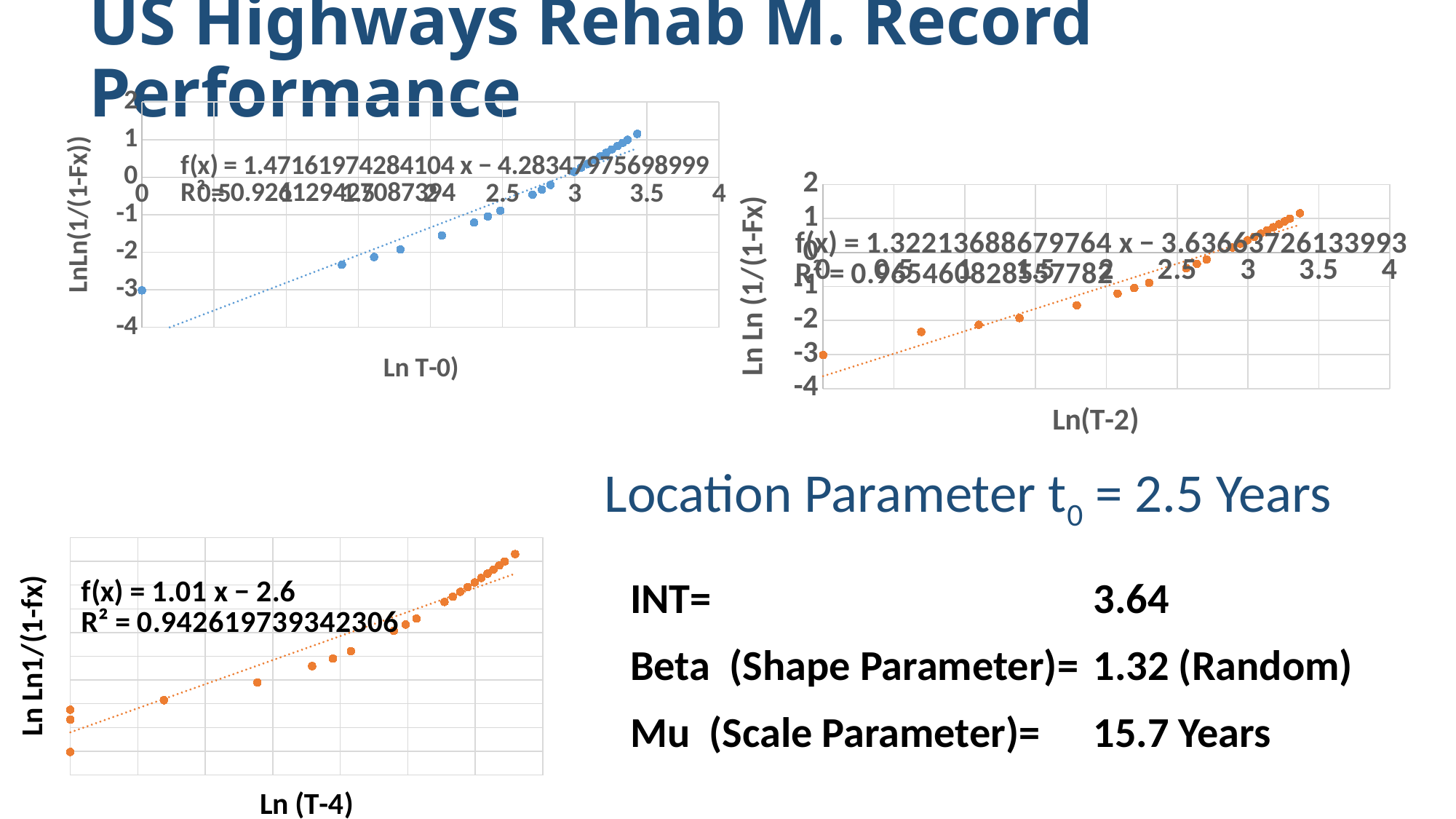
In the bottom-left chart with x-axis 'Ln (T-4)', do the plotted values rise or fall as x increases? rise What kind of chart is the bottom-left chart with x-axis 'Ln (T-4)'? scatter chart In the top-right chart with x-axis 'Ln(T-2)', do the plotted values rise or fall as x increases? rise In the top-left chart with x-axis 'Ln T-0)', is the value of the rightmost point greater or less than 0? greater What is the R² value shown on the bottom-left chart with x-axis 'Ln (T-4)'? 0.942619739342306 What is the fitted trendline equation shown on the bottom-left chart with x-axis 'Ln (T-4)'? f(x) = 1.01 x − 2.6 In the top-left chart with x-axis 'Ln T-0)', is the value of the point at x = 0 greater or less than -2? less What kind of chart is the top-left chart with x-axis 'Ln T-0)'? scatter chart In the top-right chart with x-axis 'Ln(T-2)', is the value of the point at x = 0 greater or less than -2? less